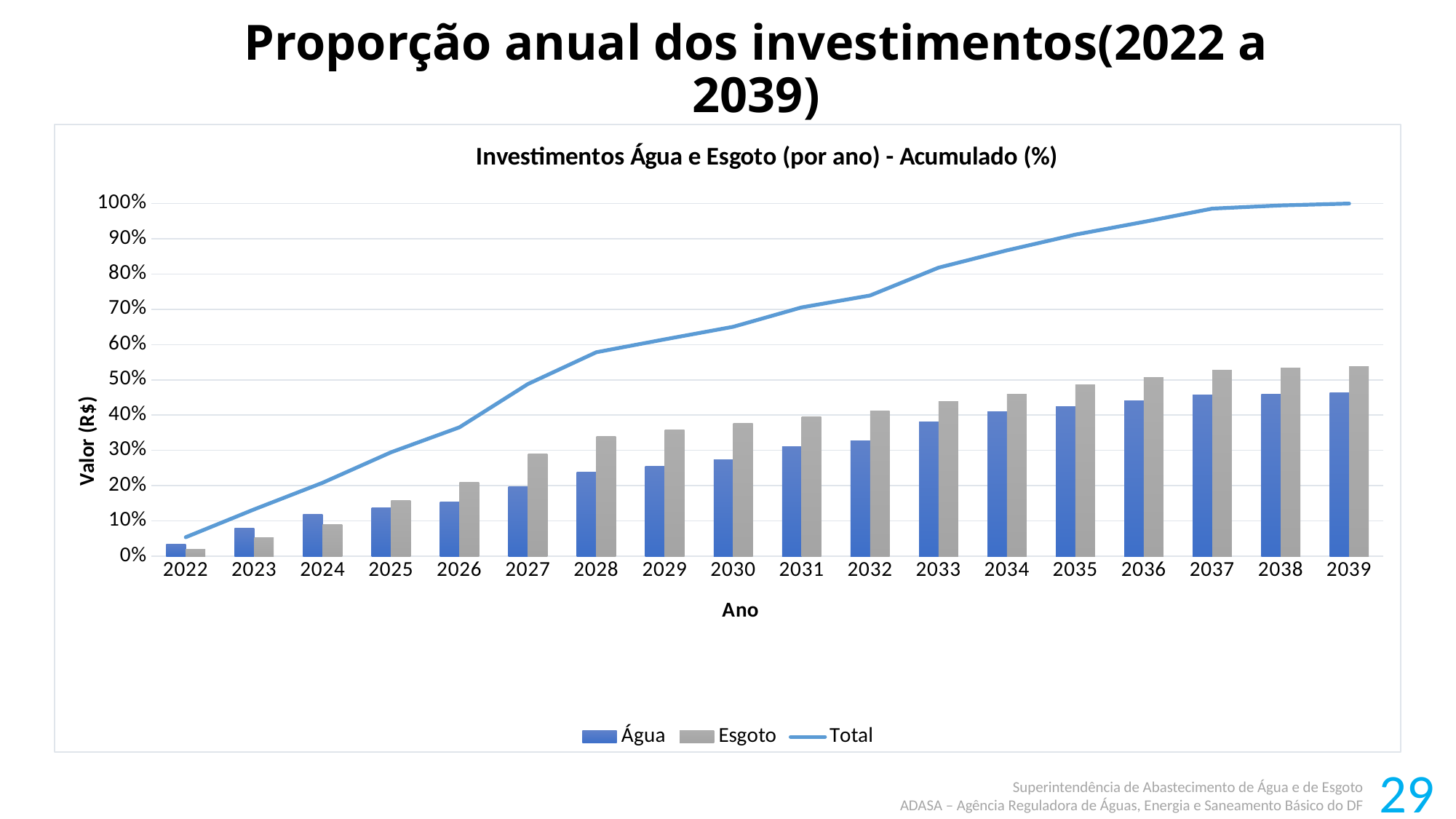
Is the Esgoto value for 2039 greater or less than 50%? greater Is the Total value for 2028 greater or less than 50%? greater In which year is the Água bar lowest? 2022 How many years are shown on the x axis? 18 Is the Água value for 2026 greater or less than 20%? less What kind of chart is shown on the slide? bar and line chart In which year is the Esgoto bar highest? 2039 In 2039, which is larger, Água or Esgoto? Esgoto Does the Total line rise or fall from 2022 to 2039? rises How many series does the legend list? 3 Which series is drawn as a line rather than bars? Total In 2022, which is larger, Água or Esgoto? Água